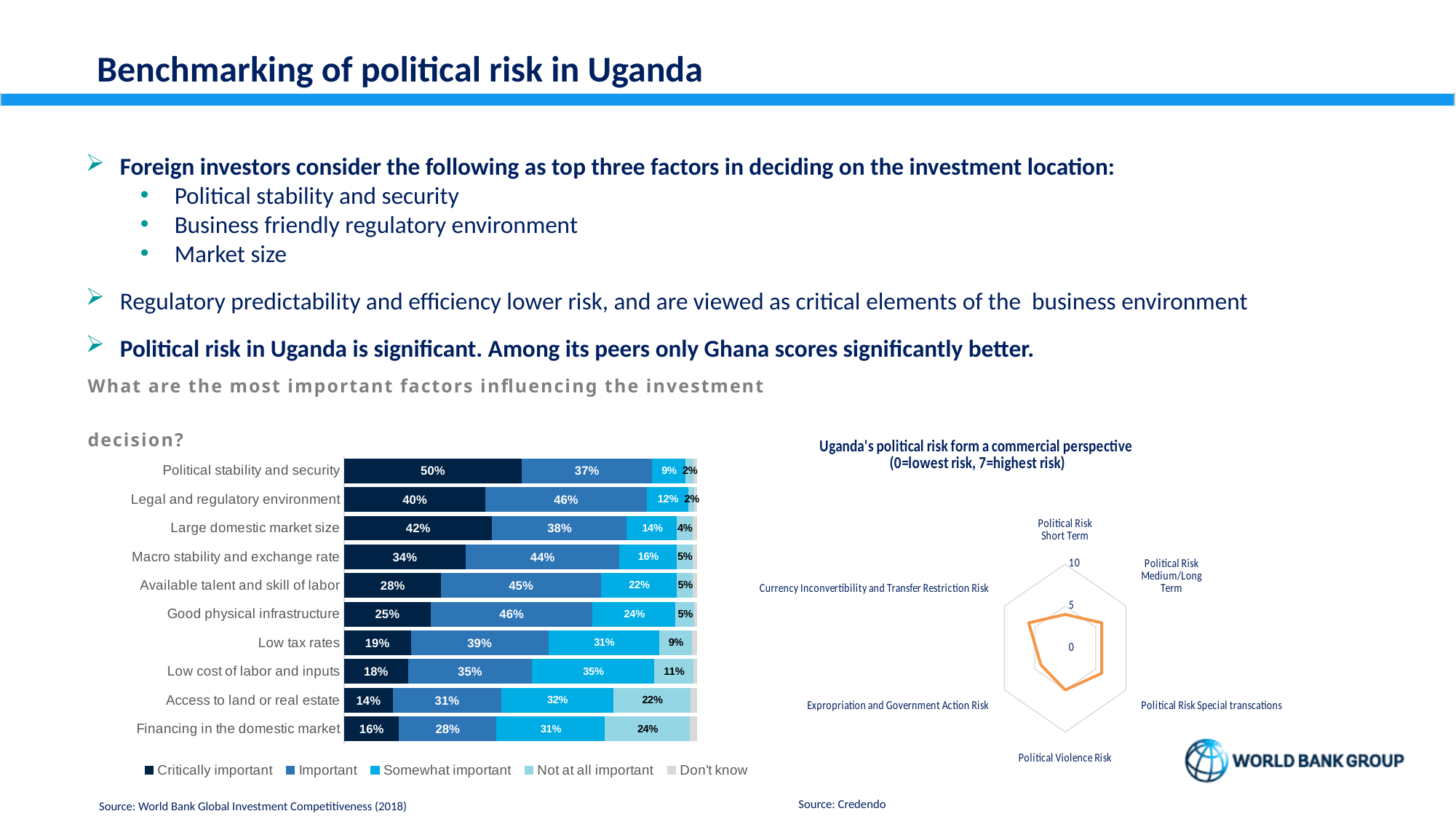
How many risk categories are shown on the radar chart 'Uganda's political risk form a commercial perspective'? 6 What kind of chart is 'Uganda's political risk form a commercial perspective'? Radar chart In the chart 'What are the most important factors influencing the investment decision?', what percentage rated 'Financing in the domestic market' as Not at all important? 24% How many series does the legend of the chart 'What are the most important factors influencing the investment decision?' list? 5 In the chart 'What are the most important factors influencing the investment decision?', what percentage of respondents rated 'Political stability and security' as Critically important? 50% In the chart 'What are the most important factors influencing the investment decision?', which has a larger Somewhat important share: 'Low tax rates' or 'Low cost of labor and inputs'? Low cost of labor and inputs In the chart 'What are the most important factors influencing the investment decision?', what is the difference in the Critically important share between 'Political stability and security' and 'Legal and regulatory environment'? 10 percentage points In the chart 'What are the most important factors influencing the investment decision?', which factor has the lowest Critically important share? Access to land or real estate What kind of chart is 'What are the most important factors influencing the investment decision?'? Stacked bar chart In the chart 'What are the most important factors influencing the investment decision?', what percentage rated 'Good physical infrastructure' as Important? 46% In the chart 'What are the most important factors influencing the investment decision?', which factor has the highest Critically important share? Political stability and security How many factors are listed in the chart 'What are the most important factors influencing the investment decision?'? 10